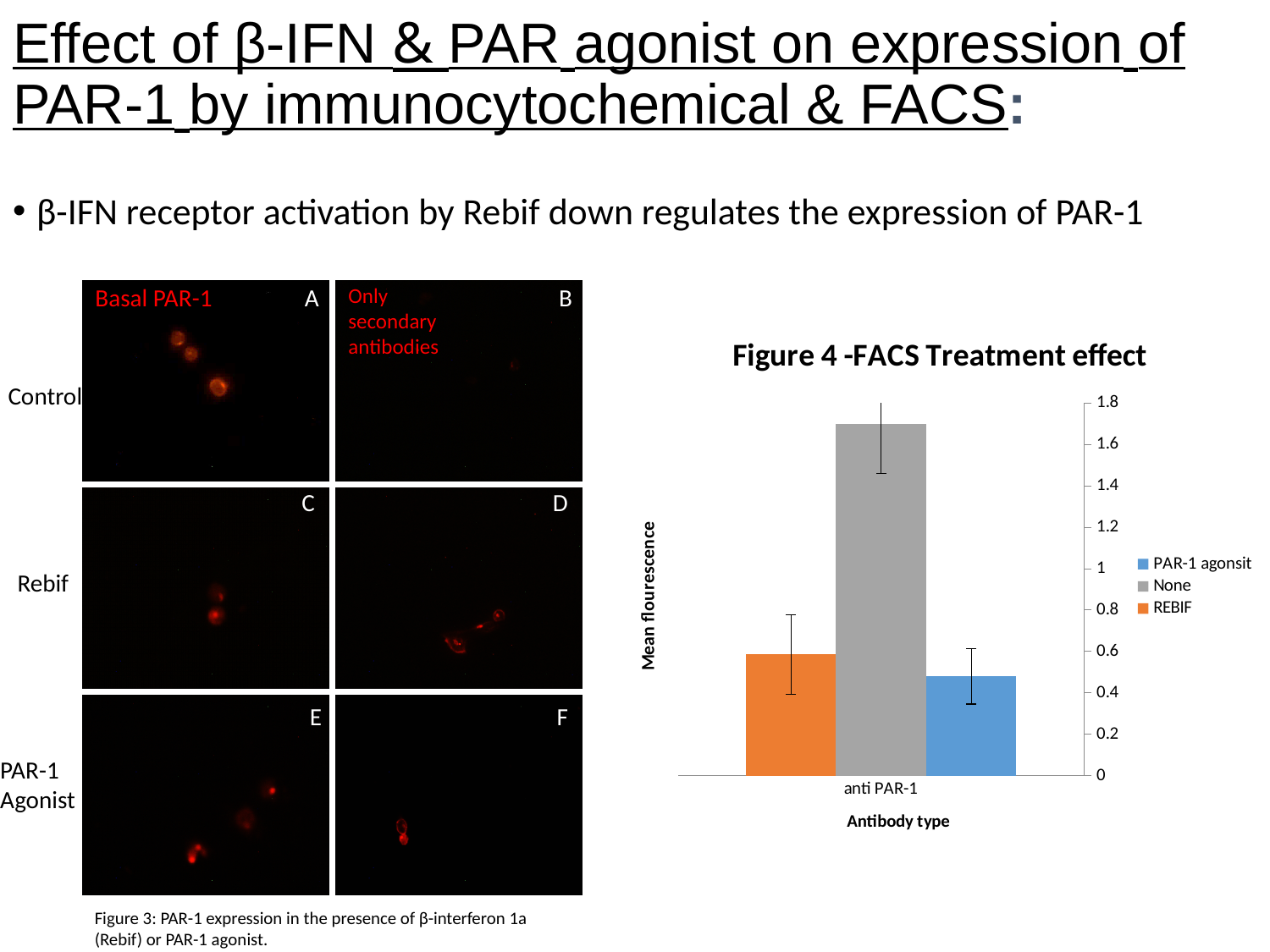
In the Figure 4 -FACS Treatment effect chart, is the value for the None series greater or less than 1.6? greater What is the y-axis label of the Figure 4 -FACS Treatment effect chart? Mean flourescence In the Figure 4 -FACS Treatment effect chart, is the value for the PAR-1 agonsit series greater or less than 0.6? less In the Figure 4 -FACS Treatment effect chart, which series is shown in orange? REBIF In the Figure 4 -FACS Treatment effect chart, which is larger for anti PAR-1: the None bar or the REBIF bar? None In the Figure 4 -FACS Treatment effect chart, which series has the highest mean fluorescence for anti PAR-1? None In the Figure 4 -FACS Treatment effect chart, which series has the lowest mean fluorescence for anti PAR-1? PAR-1 agonsit How many categories are shown on the x axis of the Figure 4 -FACS Treatment effect chart? 1 In the Figure 4 -FACS Treatment effect chart, is the value for the None series greater or less than 1.8? less What kind of chart is Figure 4 -FACS Treatment effect? bar chart How many series does the legend of the Figure 4 -FACS Treatment effect chart list? 3